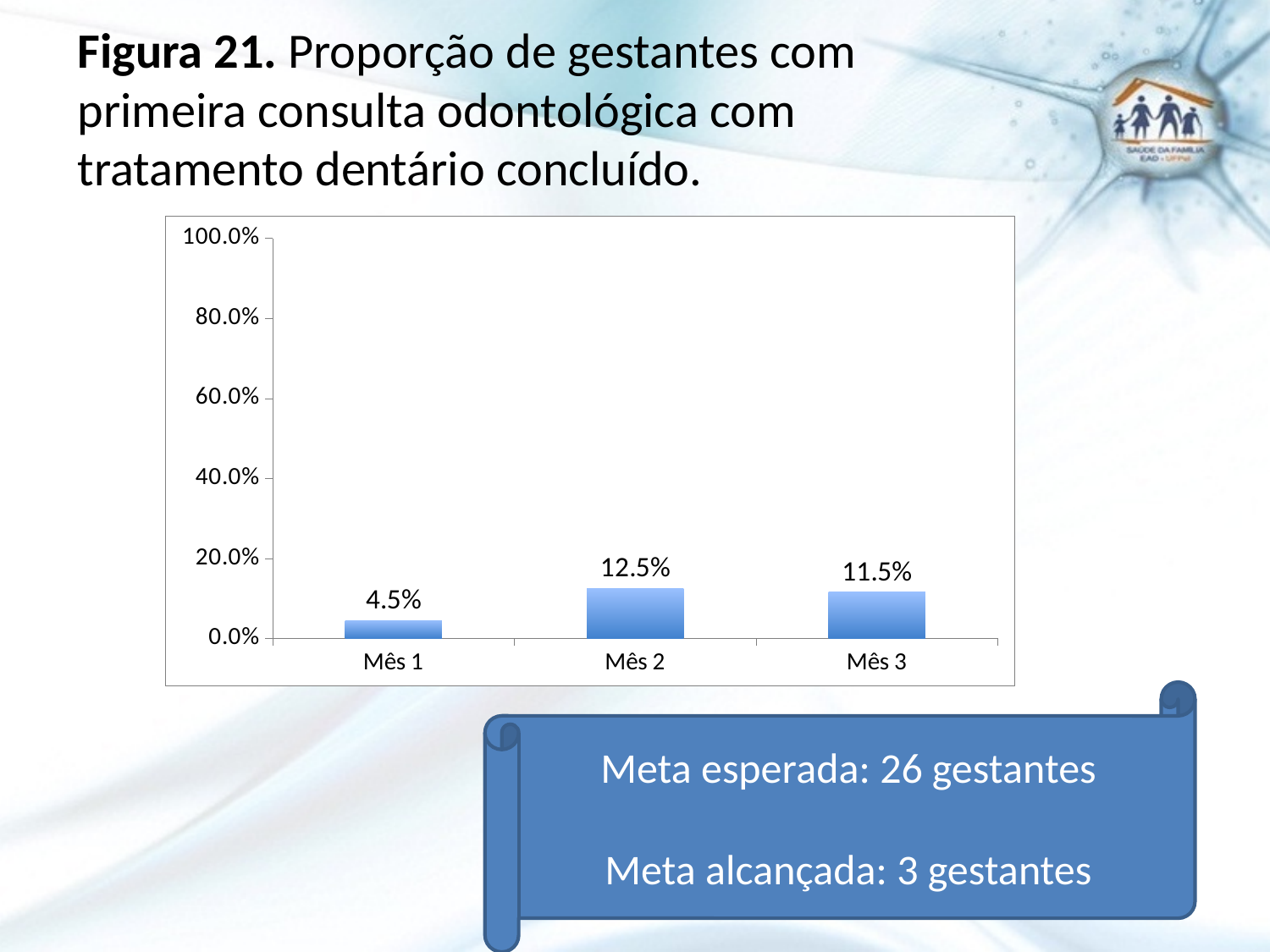
Is the value for Mês 2 greater or less than 20.0%? less What is the figure number given in the slide title? Figura 21 What is the difference between the values for Mês 2 and Mês 3? 1.0% Which is larger, the value for Mês 1 or the value for Mês 3? Mês 3 What is the value for Mês 3? 11.5% Which month has the highest value? Mês 2 What is the difference between the values for Mês 2 and Mês 1? 8.0% What is the value for Mês 2? 12.5% What kind of chart is shown on the slide? bar chart How many categories are shown on the x axis? 3 What is the value for Mês 1? 4.5% Which month has the lowest value? Mês 1